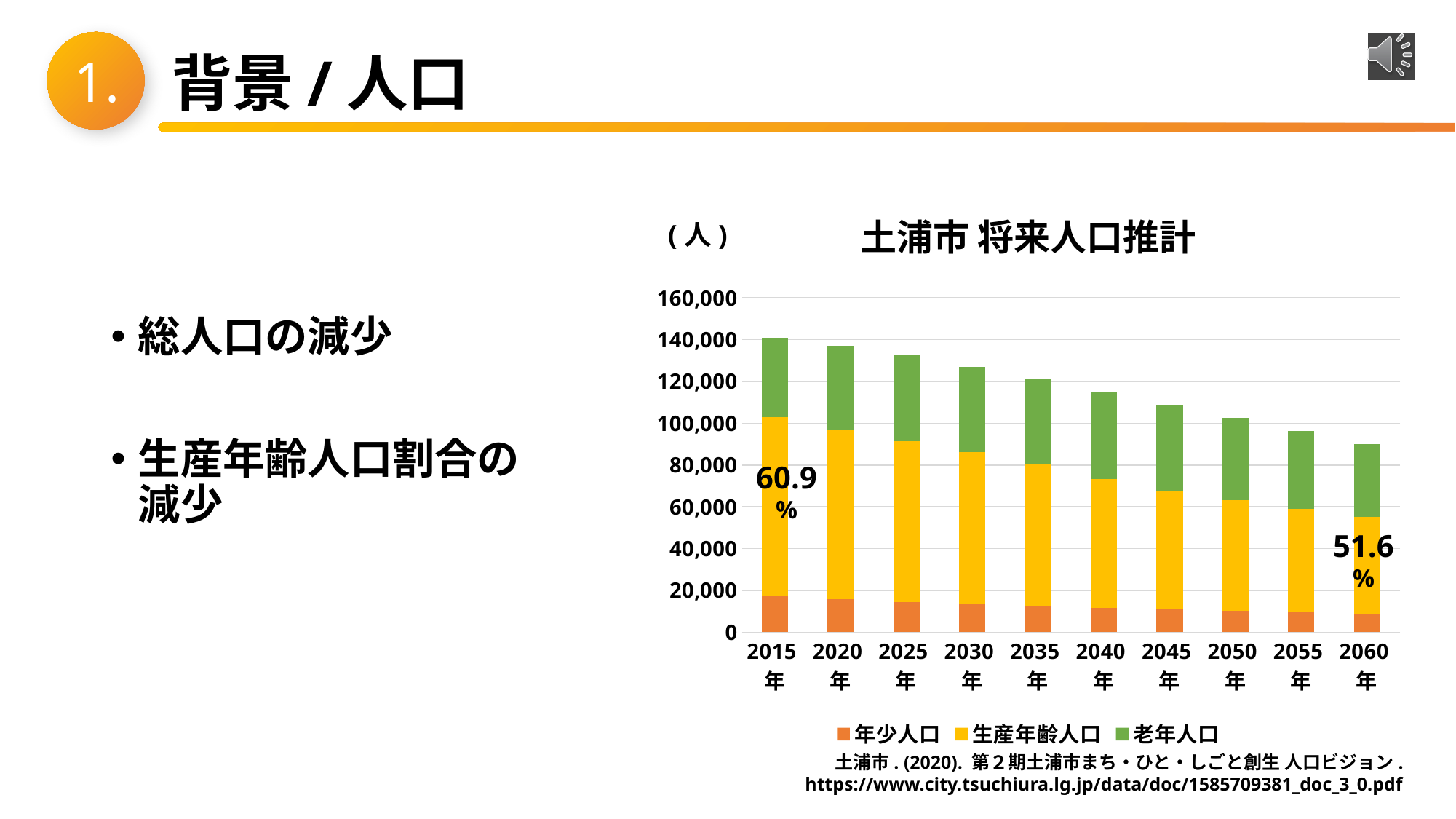
What kind of chart is shown on the slide? stacked bar chart Does the total population rise or fall from 2015年 to 2060年? fall Is the total population for 2015年 greater or less than 120,000? greater How many years (categories) are shown on the x axis of the chart? 10 What percentage label is printed on the 2015年 bar? 60.9% Which series is shown in green in the chart? 老年人口 How many series does the chart's legend list? 3 What percentage label is printed on the 2060年 bar? 51.6% Which year has the highest total population in the chart? 2015年 What is the title of the chart? 土浦市 将来人口推計 Is the total population for 2060年 greater or less than 100,000? less Which year has the lowest total population in the chart? 2060年